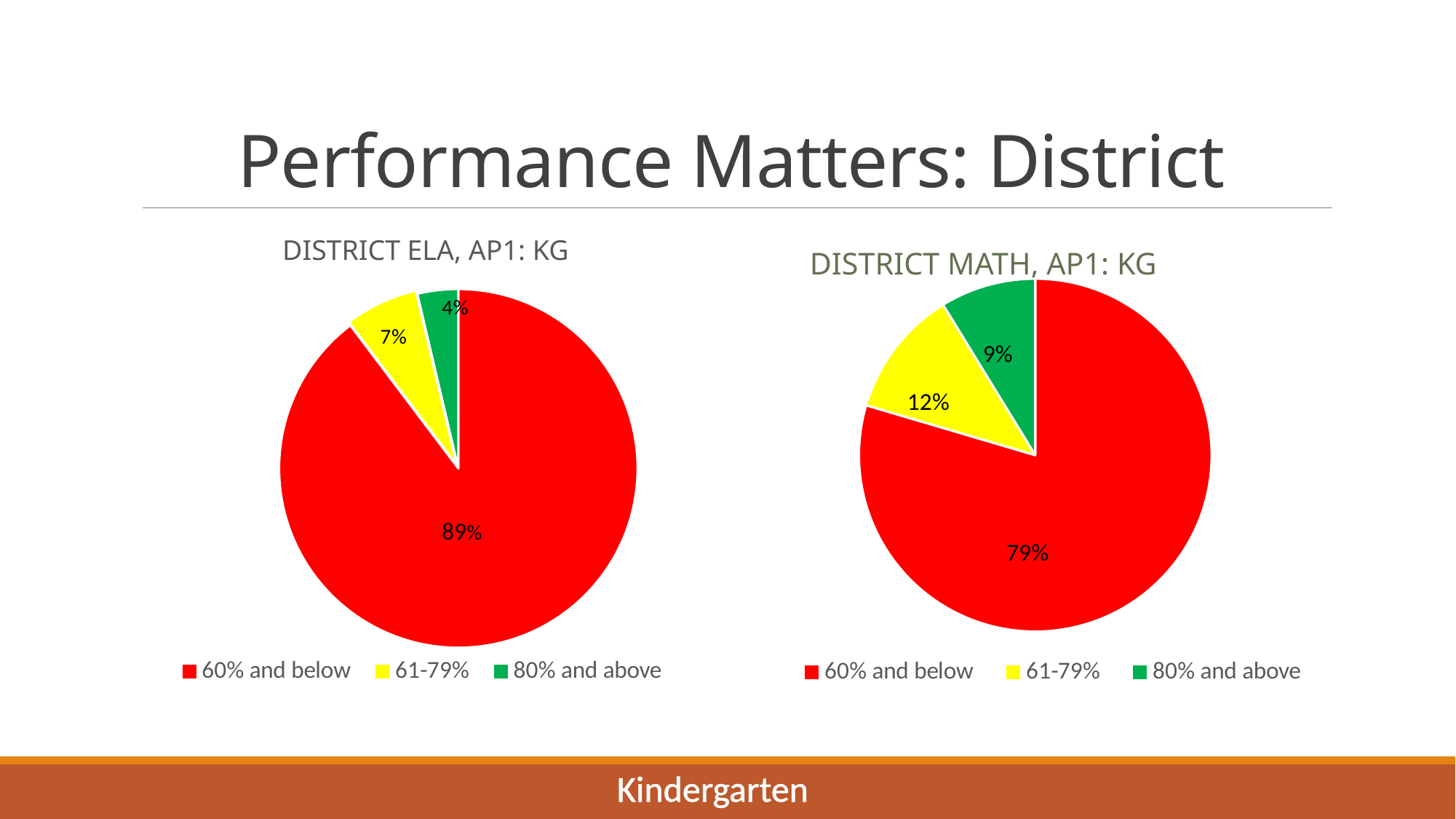
What kind of chart is the DISTRICT ELA, AP1: KG chart? Pie chart In the DISTRICT ELA, AP1: KG chart, which category has the largest slice? 60% and below In the DISTRICT ELA, AP1: KG chart, what share of the pie is '61-79%'? 7% What is the difference between the '60% and below' share in the DISTRICT ELA, AP1: KG chart and the '60% and below' share in the DISTRICT MATH, AP1: KG chart? 10% In the DISTRICT ELA, AP1: KG chart, what share of the pie is '80% and above'? 4% Which chart has the larger '80% and above' share, DISTRICT ELA, AP1: KG or DISTRICT MATH, AP1: KG? DISTRICT MATH, AP1: KG In the DISTRICT MATH, AP1: KG chart, what share of the pie is '60% and below'? 79% How many categories does the legend of the DISTRICT MATH, AP1: KG chart list? 3 In the DISTRICT MATH, AP1: KG chart, what share of the pie is '61-79%'? 12% In the DISTRICT ELA, AP1: KG chart, what share of the pie is '60% and below'? 89% In the DISTRICT MATH, AP1: KG chart, which category has the smallest slice? 80% and above In the DISTRICT MATH, AP1: KG chart, what share of the pie is '80% and above'? 9%